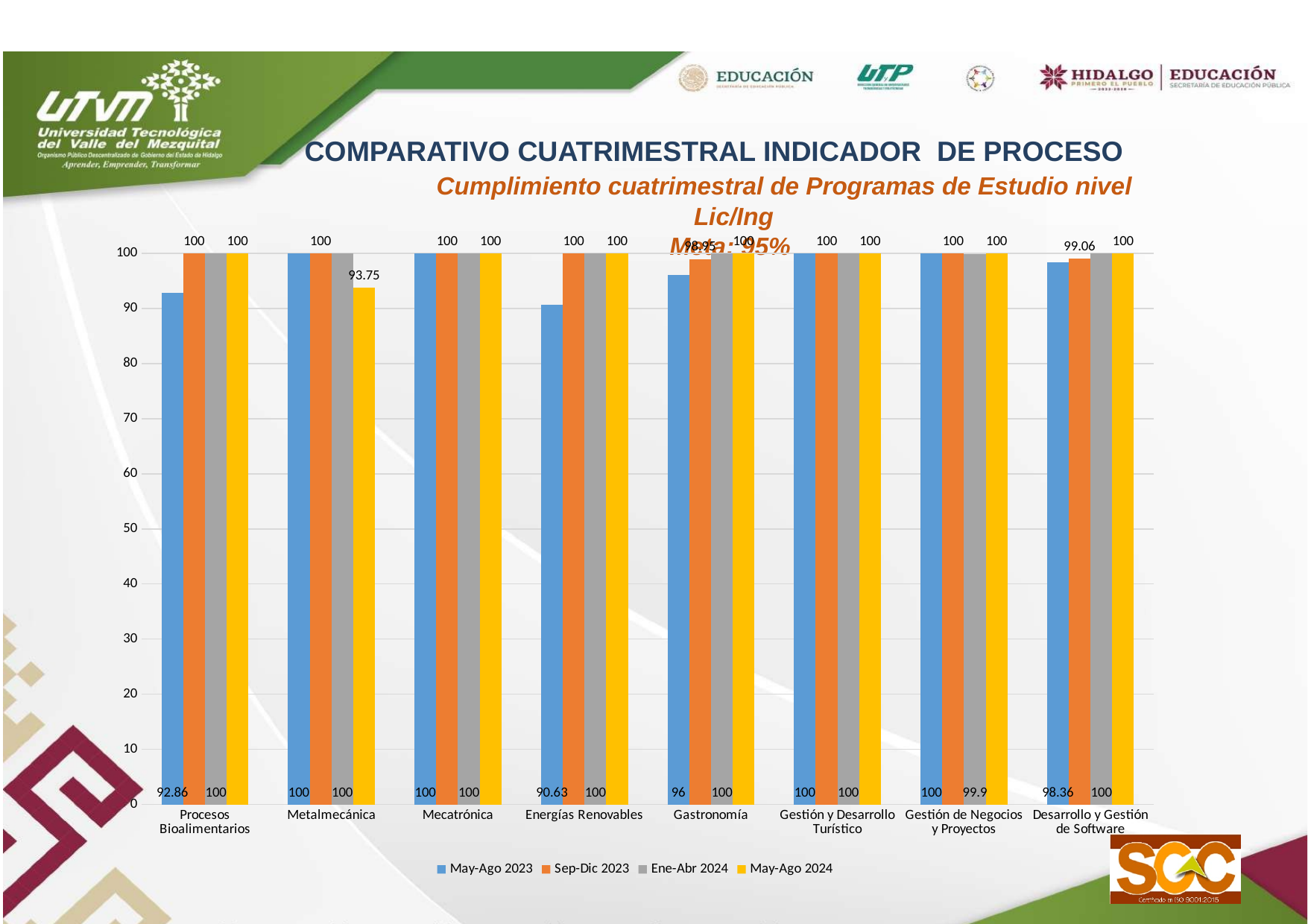
How many categories are shown on the x axis? 8 Which is larger for Gastronomía: the May-Ago 2023 value or the Ene-Abr 2024 value? Ene-Abr 2024 What is the value for Procesos Bioalimentarios in the May-Ago 2023 series? 92.86 Which category has the lowest value in the May-Ago 2023 series? Energías Renovables What is the value for Metalmecánica in the May-Ago 2024 series? 93.75 What is the difference between the May-Ago 2023 value for Procesos Bioalimentarios and its Sep-Dic 2023 value? 7.14 What is the value for Energías Renovables in the May-Ago 2023 series? 90.63 What is the value for Desarrollo y Gestión de Software in the Sep-Dic 2023 series? 99.06 What is the value for Gestión de Negocios y Proyectos in the Ene-Abr 2024 series? 99.9 How many series does the legend list? 4 Is the May-Ago 2023 value for Energías Renovables greater or less than 95? less What kind of chart is shown on the slide? bar chart